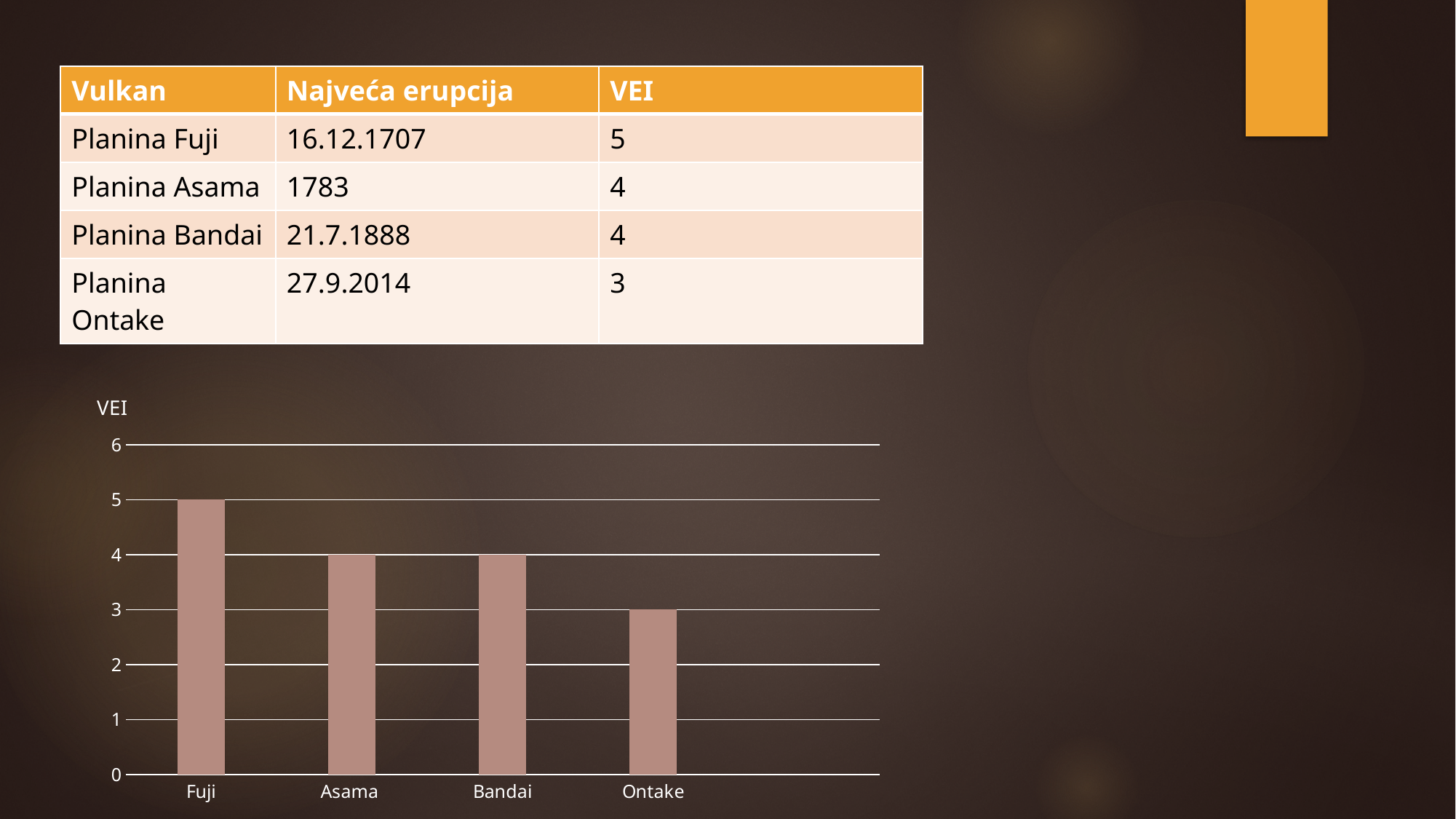
What is the VEI value for Asama in the chart? 4 What is the VEI value for Fuji in the chart? 5 How many volcanoes are plotted in the chart? 4 What kind of chart is shown on the slide? bar chart What is the VEI value for Ontake in the chart? 3 Is the value for Fuji greater or less than 4? greater What is the title of the chart? VEI Do the VEI values generally rise or fall from Fuji to Ontake along the x axis? fall Which has a larger VEI, Bandai or Ontake? Bandai Which volcano has the highest VEI in the chart? Fuji Which volcano has the lowest VEI in the chart? Ontake What is the difference between the VEI of Fuji and the VEI of Ontake? 2